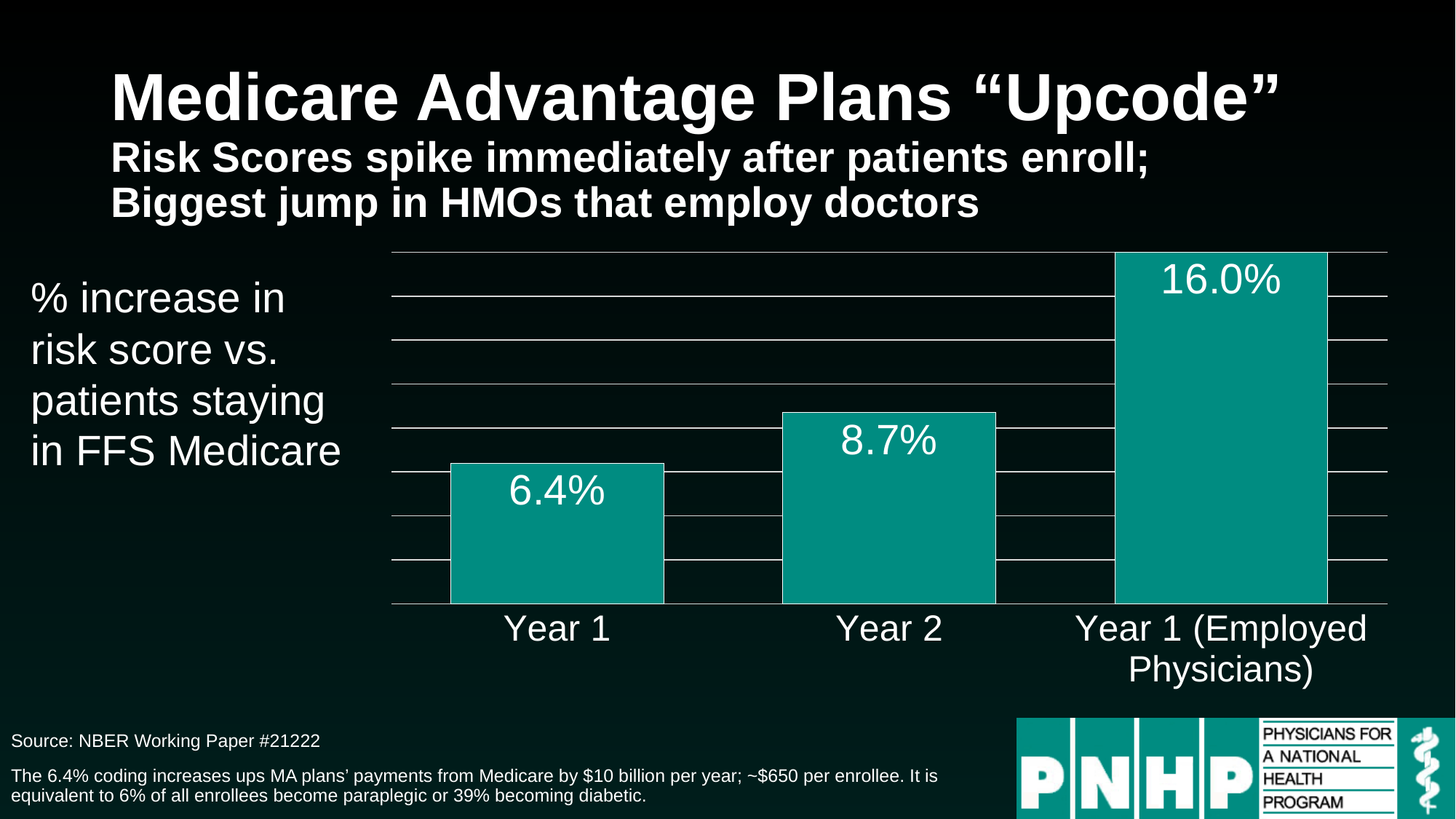
Which category has the highest % increase in risk score? Year 1 (Employed Physicians) Which category has the lowest % increase in risk score? Year 1 What is the % increase in risk score for Year 1 (Employed Physicians)? 16.0% Which is larger, the value for Year 2 or the value for Year 1 (Employed Physicians)? Year 1 (Employed Physicians) What is the difference between the Year 2 and Year 1 values? 2.3% How many categories are shown on the chart? 3 What is the difference between the Year 1 (Employed Physicians) value and the Year 1 value? 9.6% Do the values rise or fall from left to right across the categories? Rise What is the % increase in risk score for Year 1? 6.4% What colour are the bars in the chart? Teal What kind of chart is shown on the slide? Bar chart What is the % increase in risk score for Year 2? 8.7%